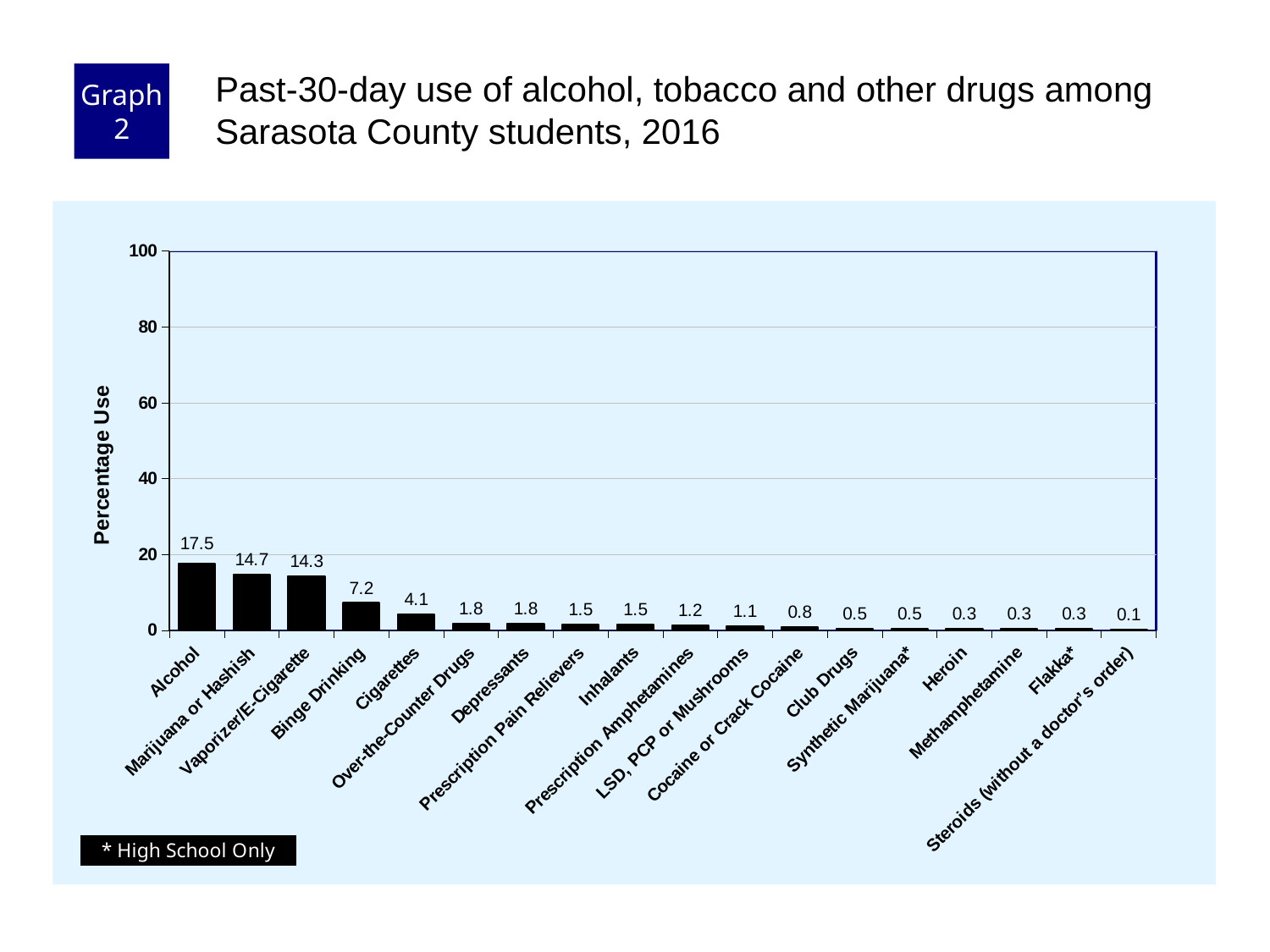
What is the percentage use for Alcohol? 17.5 Is the value for Vaporizer/E-Cigarette greater or less than 20? less What kind of chart is shown on the slide? Bar chart What is the percentage use for Binge Drinking? 7.2 Which category has the lowest percentage use? Steroids (without a doctor's order) How many categories are shown on the x axis? 18 Which has a higher percentage use, Cigarettes or Binge Drinking? Binge Drinking What is the difference in percentage use between Alcohol and Marijuana or Hashish? 2.8 What is the percentage use for Cocaine or Crack Cocaine? 0.8 What is the label of the y axis? Percentage Use Which category has the highest percentage use? Alcohol What is the percentage use for Steroids (without a doctor's order)? 0.1